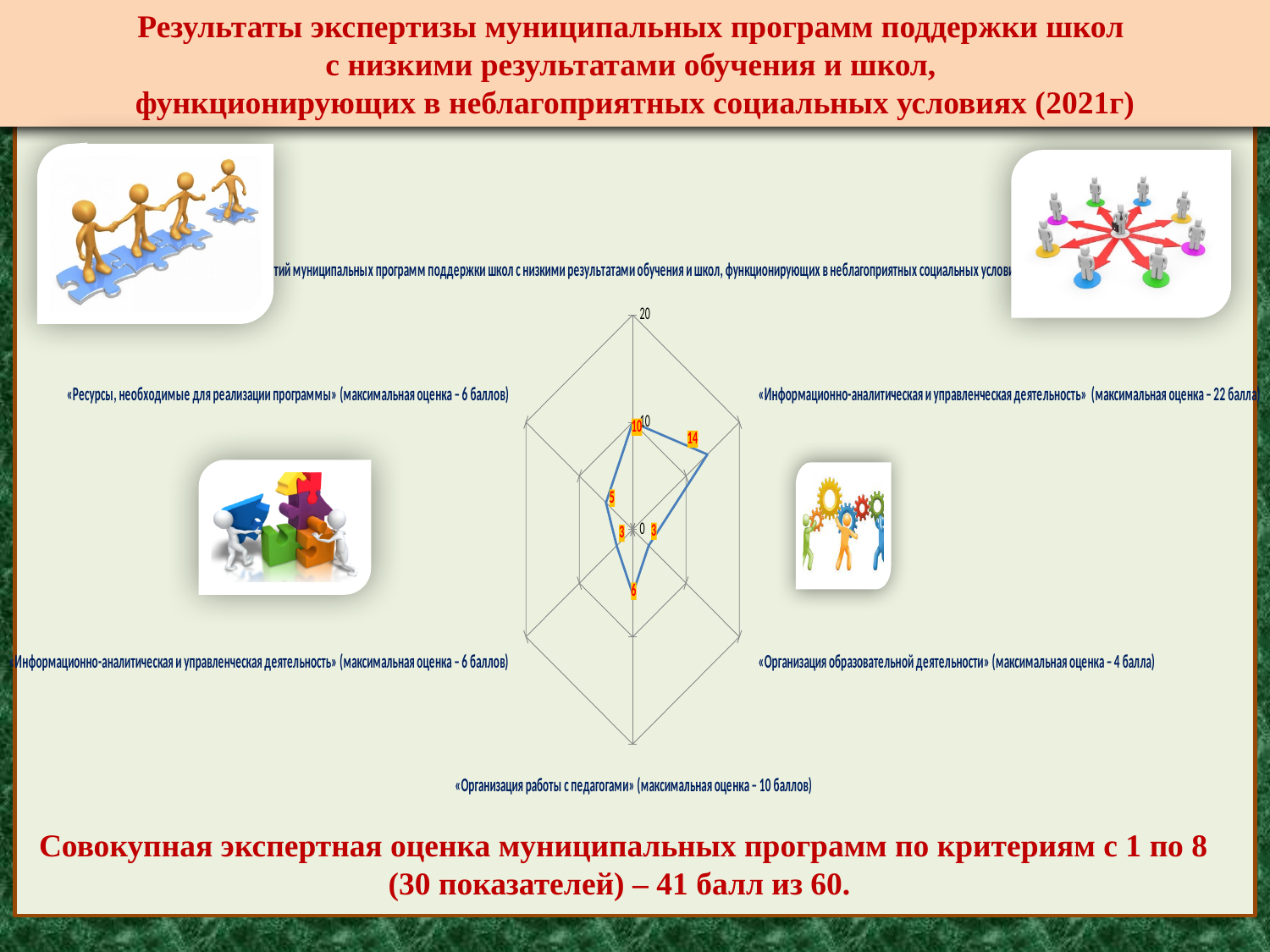
Which is larger: the value for «Ресурсы, необходимые для реализации программы» or the value for «Организация работы с педагогами»? «Организация работы с педагогами» What is the value for «Информационно-аналитическая и управленческая деятельность» (максимальная оценка – 22 балла) on the radar chart? 14 What is the difference between the value for «Информационно-аналитическая и управленческая деятельность» (максимальная оценка – 22 балла) and the value for «Организация работы с педагогами»? 8 What is the value for «Организация образовательной деятельности» on the radar chart? 3 What is the maximum tick value shown on the radar chart's scale? 20 What is the difference between the value for «Ресурсы, необходимые для реализации программы» and the value for «Организация образовательной деятельности»? 2 What is the value for «Ресурсы, необходимые для реализации программы» on the radar chart? 5 How many axes (categories) does the radar chart have? 6 What is the value for «Организация работы с педагогами» on the radar chart? 6 Which category has the highest value on the radar chart? «Информационно-аналитическая и управленческая деятельность» (максимальная оценка – 22 балла) What kind of chart is shown on the slide? radar chart Is the value for «Информационно-аналитическая и управленческая деятельность» (максимальная оценка – 22 балла) greater or less than 10? greater